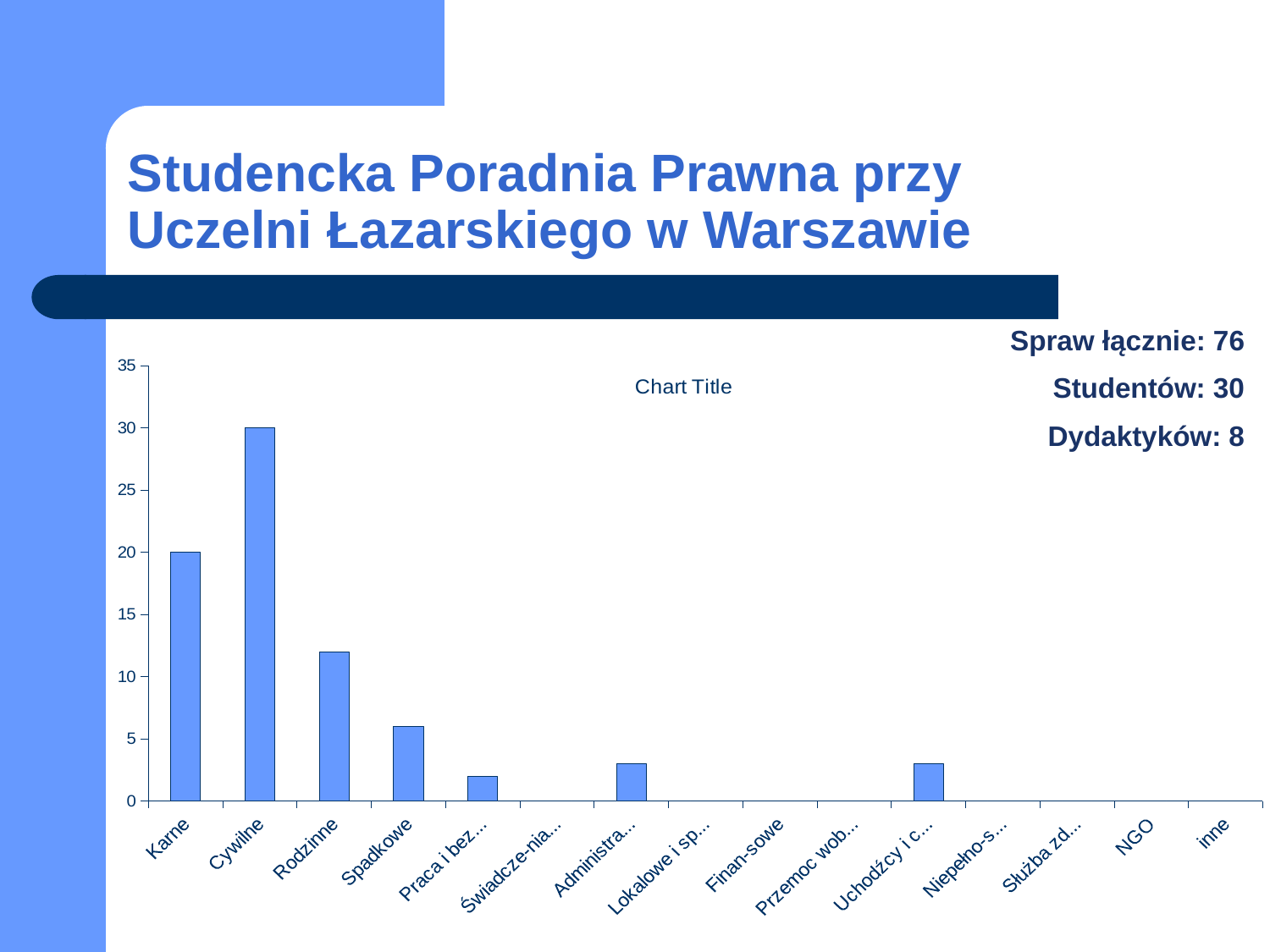
What is the value for Karne? 20 Which is larger, the value for Spadkowe or the value for NGO? Spadkowe What is the value for Cywilne? 30 Is the value for Spadkowe greater or less than 10? less What is the difference between the values for Cywilne and Karne? 10 How many categories are shown on the x axis? 15 Which is larger, the value for Karne or the value for Rodzinne? Karne What type of chart is shown on the slide? bar chart Which category has the highest value? Cywilne What is the title shown on the chart? Chart Title Is the value for Rodzinne greater or less than 10? greater Is the value for Cywilne greater or less than 25? greater